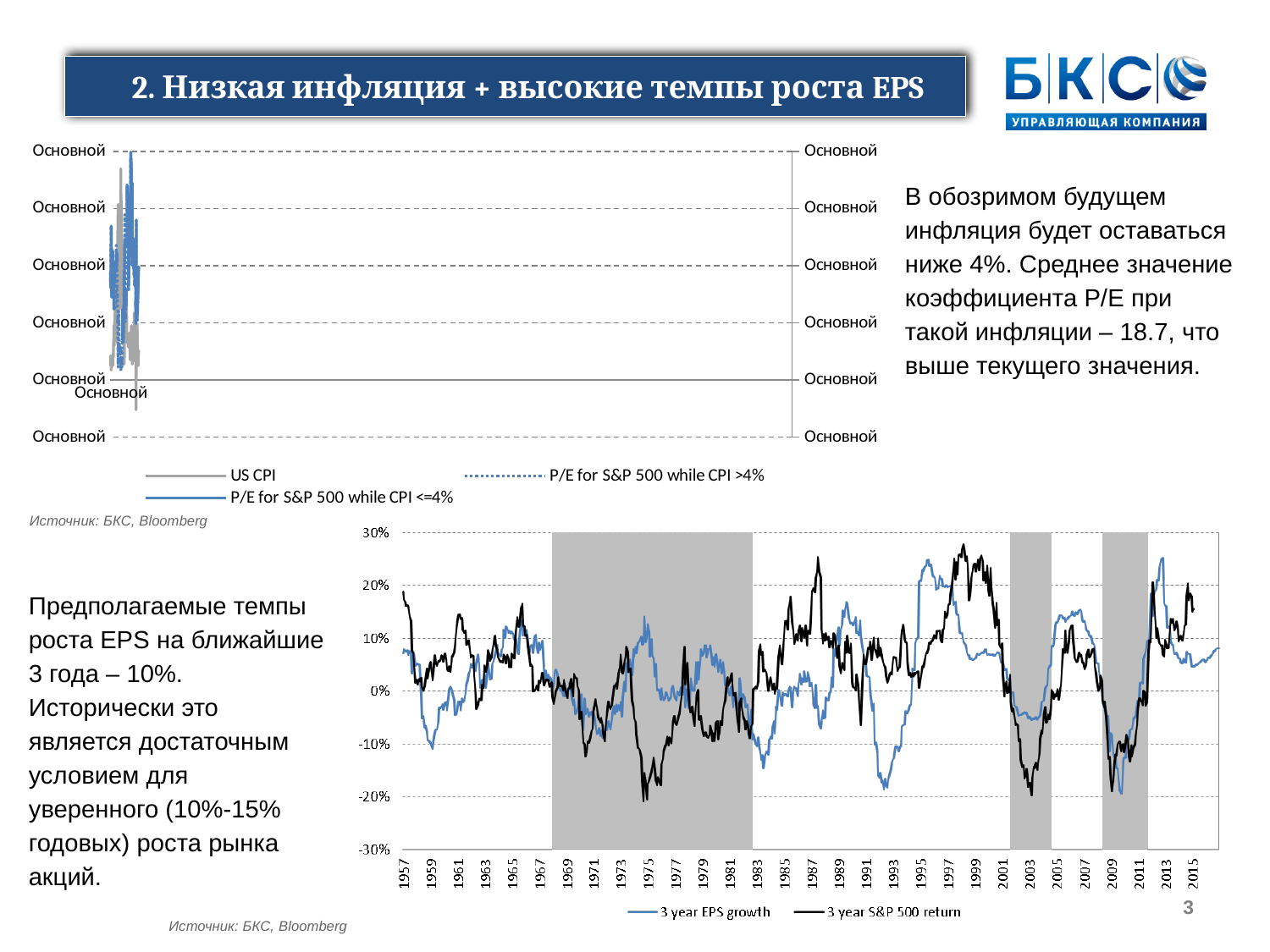
In the bottom chart, what is the lowest value shown on the y axis? -30% In the bottom chart, is the 3 year S&P 500 return around 1975 greater or less than -10%? less In the bottom chart, which series is drawn in black? 3 year S&P 500 return In the bottom chart, which series is drawn in blue? 3 year EPS growth What kind of chart is the bottom chart on the slide? line chart In the bottom chart, what is the highest value shown on the y axis? 30% In the bottom chart, is the 3 year S&P 500 return around 1999 greater or less than 20%? greater How many series does the legend of the bottom chart list? 2 In the bottom chart, what is the last year shown on the x axis? 2015 In the bottom chart, is the 3 year EPS growth around 1993 greater or less than -10%? less How many series does the legend of the top chart list? 3 In the bottom chart, what is the first year shown on the x axis? 1957